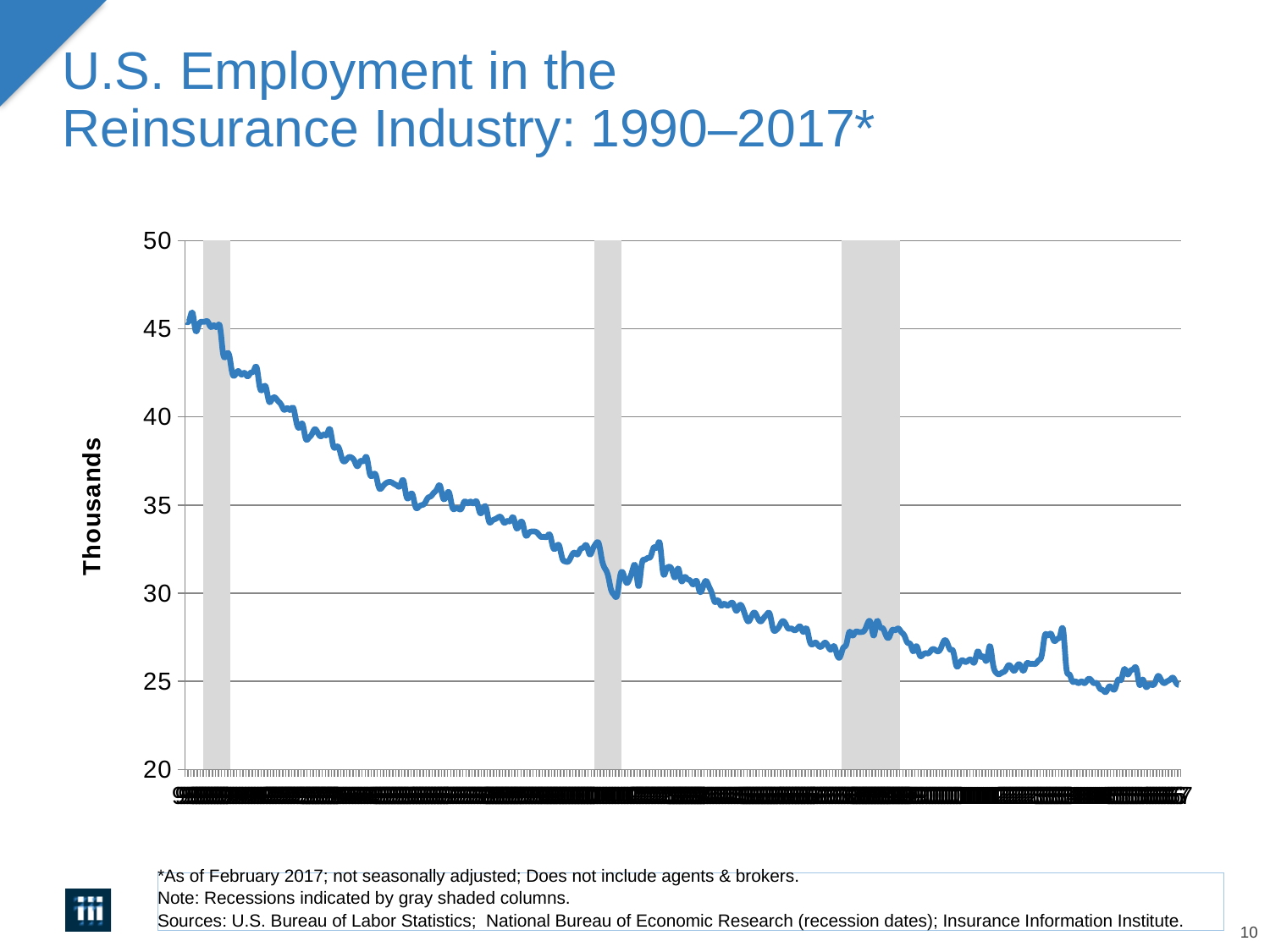
Is the value at the start of the series greater or less than 35? greater Is the highest point on the line greater or less than 50? less Do the values generally rise or fall from left to right along the x axis? fall Is the value at the start of the series (left end of the line) greater or less than 40? greater Which end of the line is higher, the left end or the right end? left end What kind of chart is shown on the slide? line chart How many gray shaded recession columns appear on the chart? 3 What is the label on the vertical axis? Thousands How many lines (data series) are plotted on the chart? 1